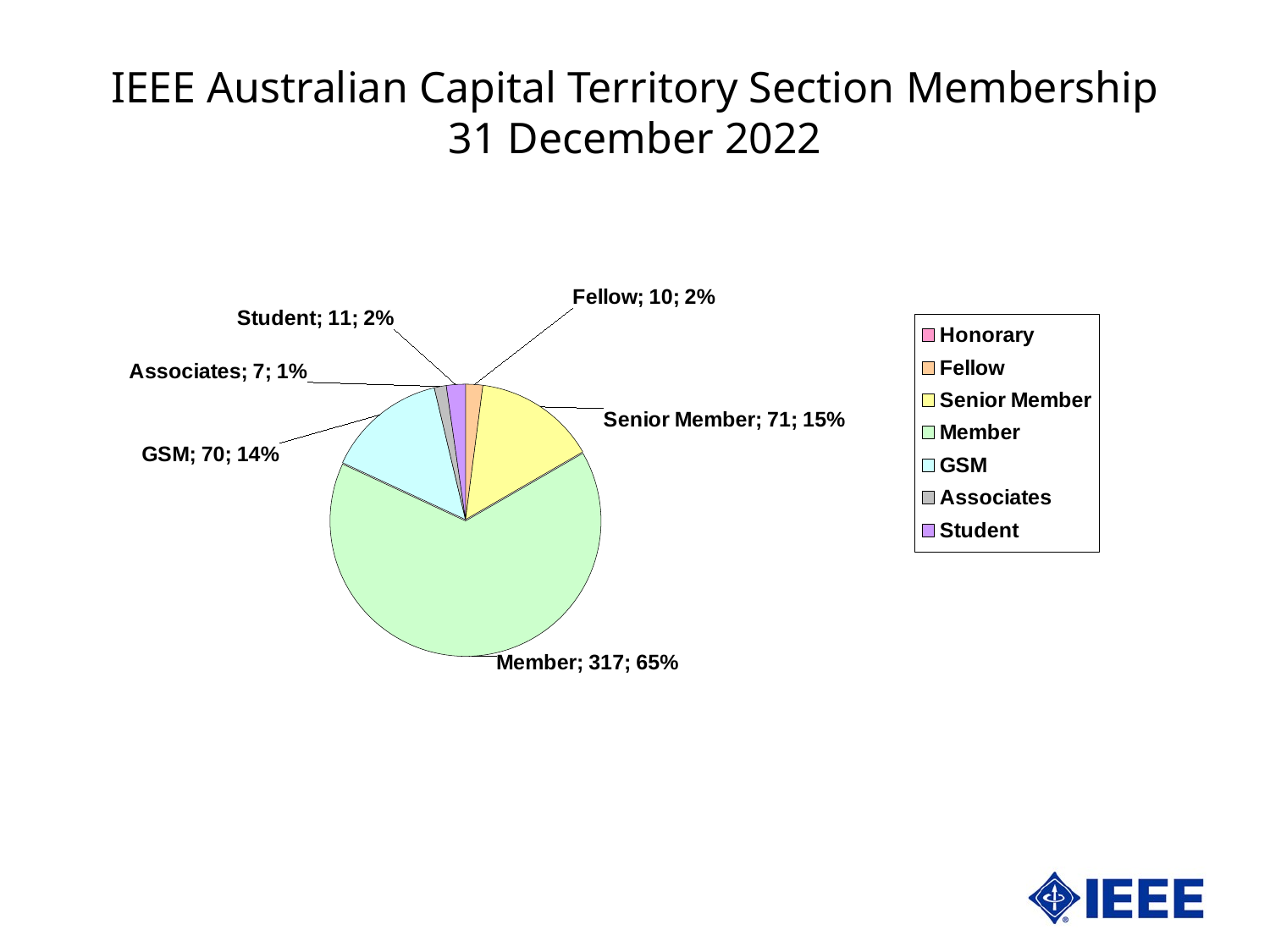
Which labelled category has the smallest slice of the pie? Associates What is the difference between the Member count and the Senior Member count? 246 How many members are in the Member category? 317 What is the title of the slide containing the chart? IEEE Australian Capital Territory Section Membership 31 December 2022 What percentage share of the pie does the Senior Member slice represent? 15% How many entries does the legend list? 7 How many members are in the GSM category? 70 Which category has the largest slice of the pie? Member What is the value shown for Associates? 7 What percentage share of the pie does the Member slice represent? 65% Which is larger, the Student count or the Fellow count? Student What kind of chart is shown on the slide? pie chart